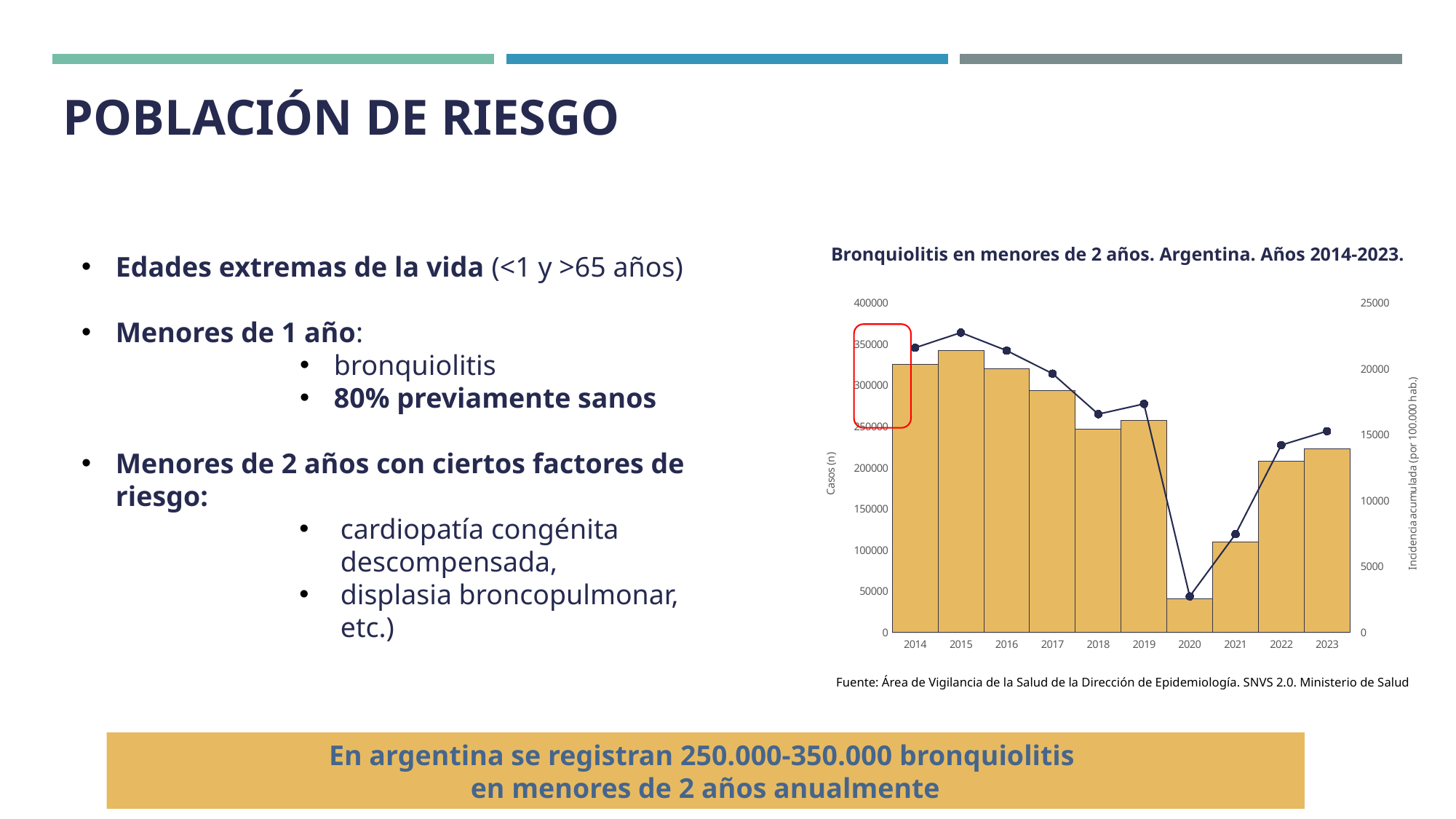
Do the number of cases rise or fall from 2020 to 2023? rise Which year has more cases, 2021 or 2022? 2022 Is the number of cases for 2021 greater or less than 100000? greater Is the number of cases for 2017 greater or less than 300000? less Which year has the lowest bar (fewest cases) in the chart? 2020 What kind of chart is shown on the slide? bar chart with a line How many years are shown on the x axis of the chart? 10 Is the number of cases for 2020 greater or less than 50000? less Which year has the highest bar (most cases) in the chart? 2015 What is the title of the chart? Bronquiolitis en menores de 2 años. Argentina. Años 2014-2023. What is the label of the left vertical axis of the chart? Casos (n)